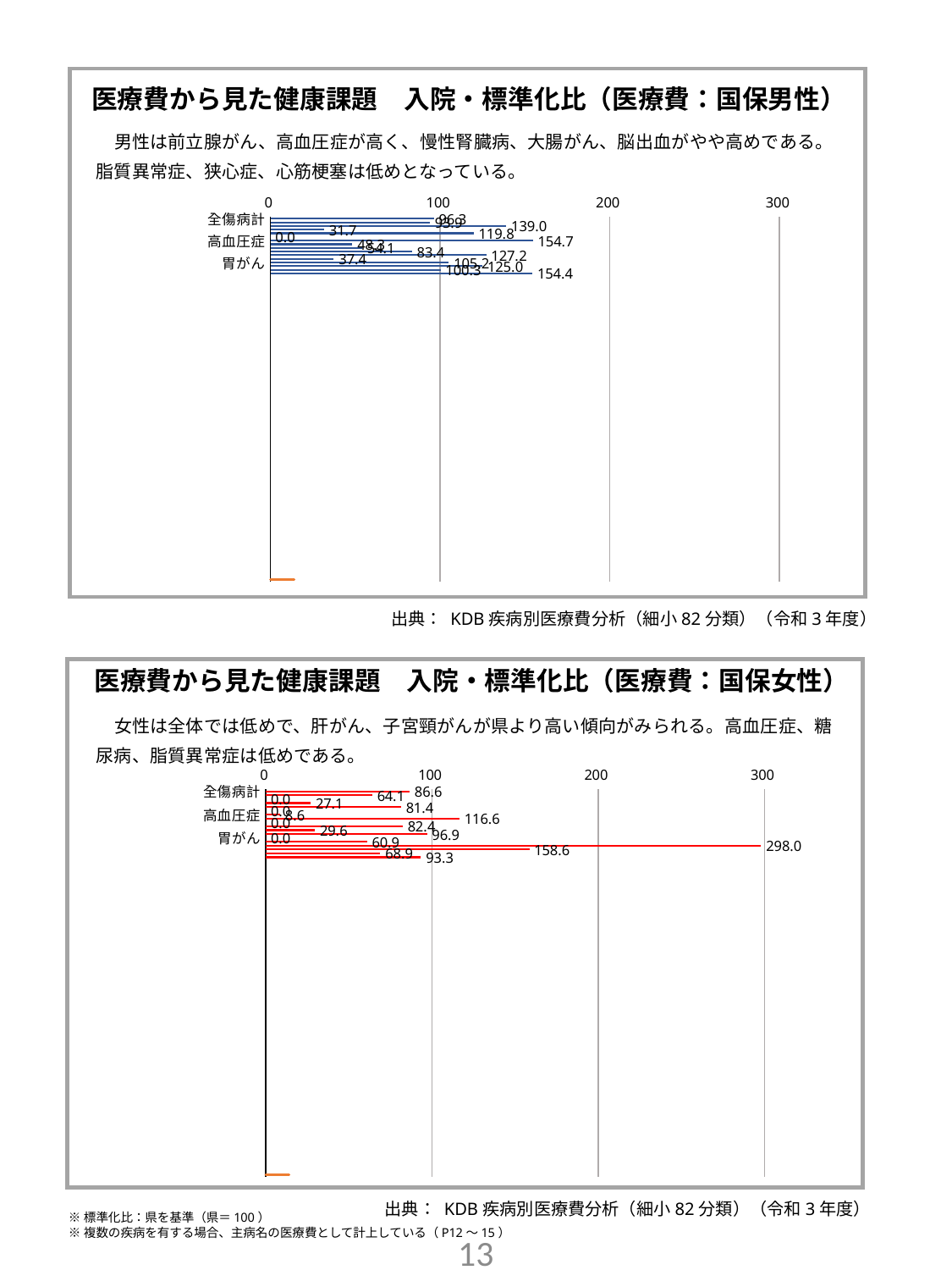
In the top chart (国保男性), is the value for 全傷病計 greater or less than 100? less What colour are the bars in the bottom chart (国保女性)? red What kind of chart is shown in the top panel (医療費：国保男性)? bar chart In the bottom chart (国保女性), what is the value for 全傷病計? 86.6 In the top chart (国保男性), is the longest bar greater or less than 200? less In the bottom chart (国保女性), is the longest bar greater or less than 200? greater What kind of chart is shown in the bottom panel (医療費：国保女性)? bar chart In the bottom chart (国保女性), what is the largest value labelled on any bar? 298.0 What is the highest tick value shown on the horizontal axis of the top chart (国保男性)? 300